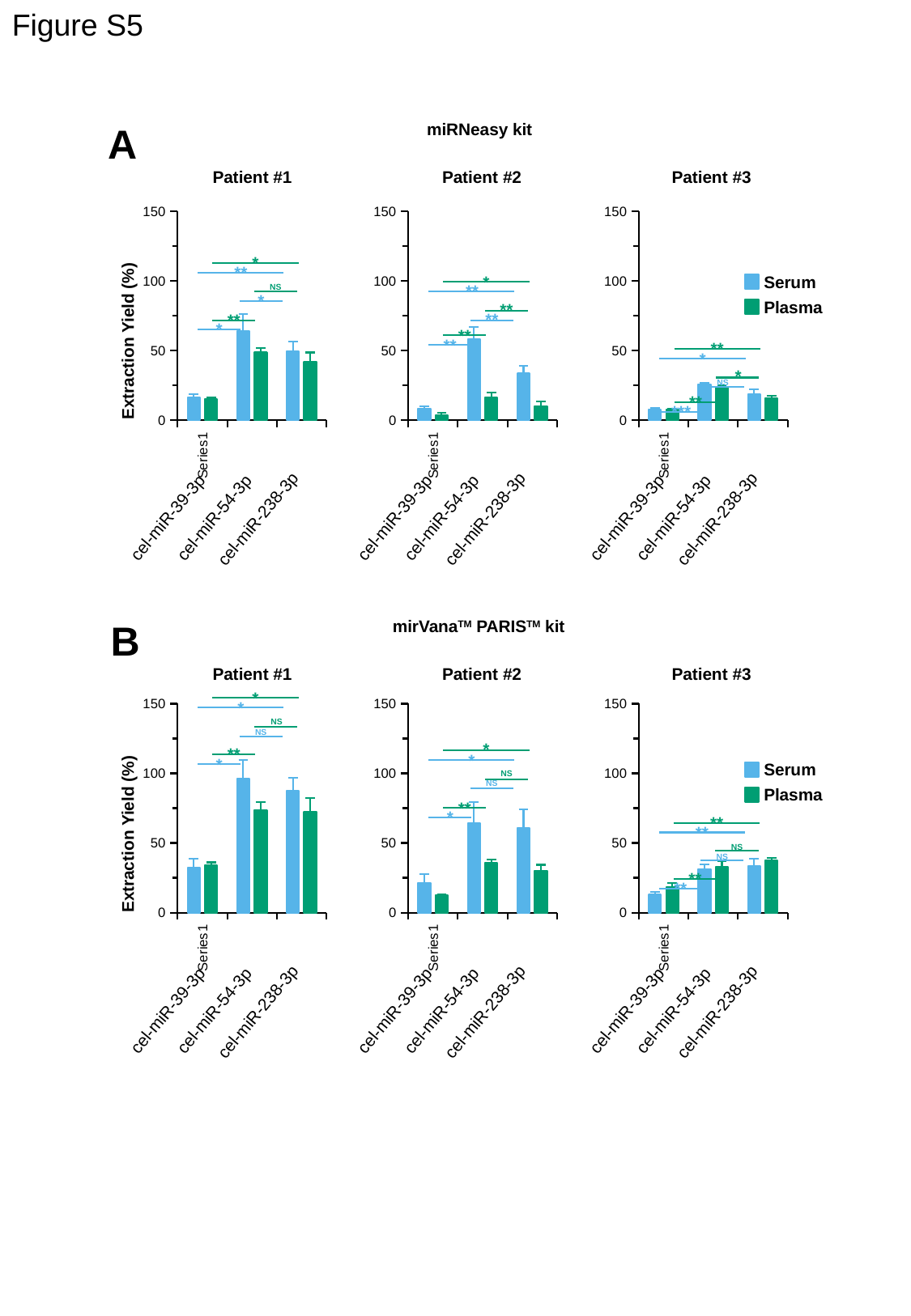
What is the y-axis label on the charts in panel B? Extraction Yield (%) In the panel A Patient #1 chart, which category has the lowest Plasma value? cel-miR-39-3p How many series does the legend list for the Patient #3 chart in panel A? 2 In the panel A Patient #3 chart, is the Serum value for cel-miR-54-3p greater or less than 50? less In the panel B Patient #2 chart, is the Plasma value for cel-miR-39-3p greater or less than 50? less How many categories are shown on the x axis of the Patient #2 chart in panel B (mirVana PARIS kit)? 3 In the panel A Patient #2 chart, which is larger for cel-miR-54-3p, the Serum value or the Plasma value? Serum What kind of chart is used for Patient #1 in panel A (miRNeasy kit)? Bar chart In the panel B Patient #1 chart, is the Serum value for cel-miR-54-3p greater or less than 50? greater In the panel A Patient #2 chart, which category has the highest Serum value? cel-miR-54-3p In the panel B Patient #2 chart, which is larger for cel-miR-238-3p, the Serum value or the Plasma value? Serum